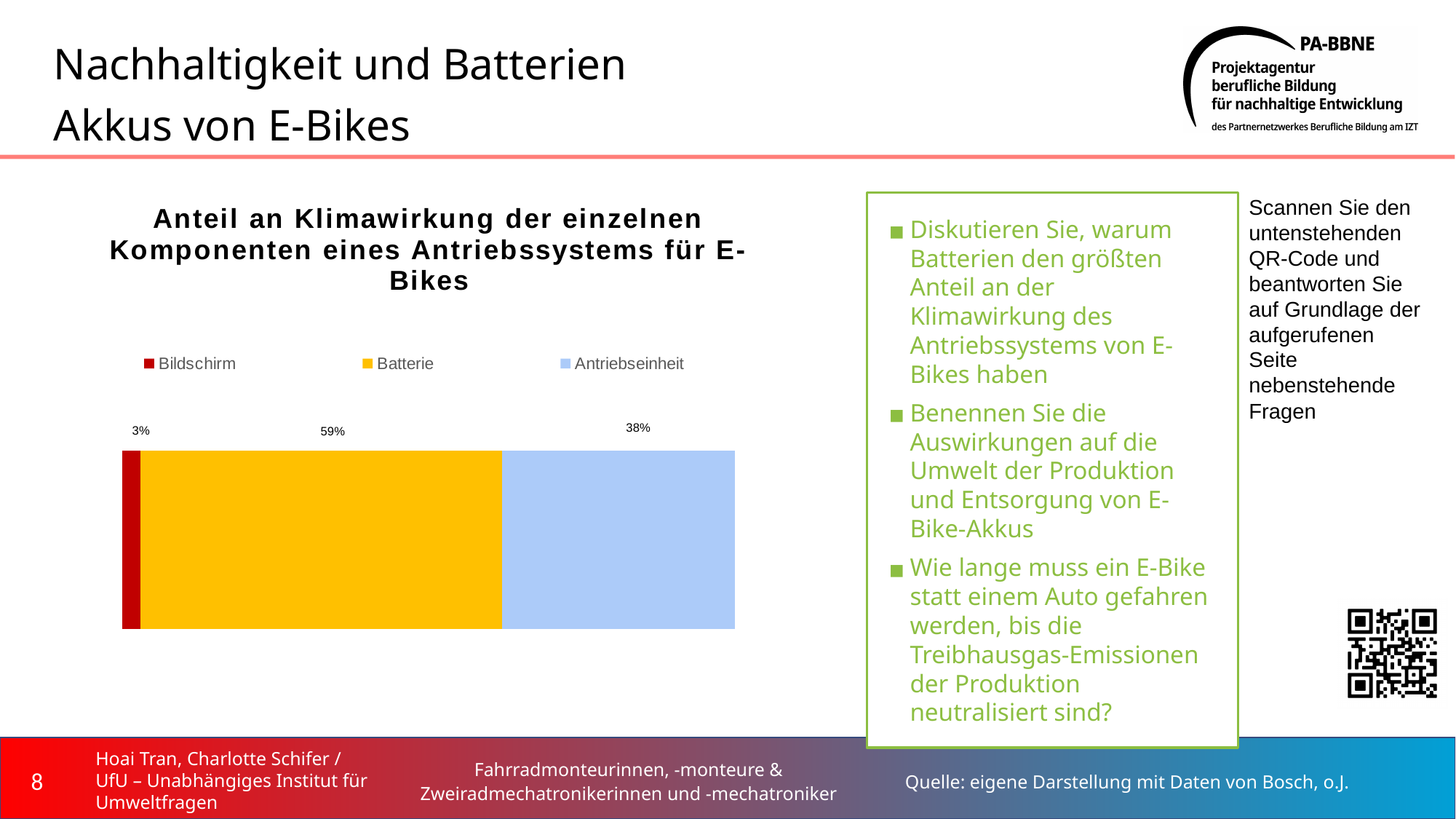
What is the title of the chart? Anteil an Klimawirkung der einzelnen Komponenten eines Antriebssystems für E-Bikes What type of chart is shown on the slide? Stacked bar chart Which component has the largest share of the climate impact in the chart? Batterie What value is shown for Antriebseinheit in the chart? 38% Which component has the smallest share of the climate impact in the chart? Bildschirm What value is shown for Bildschirm in the chart? 3% What share of the climate impact does the Batterie segment account for in the chart? 59% How many series does the chart legend list? 3 Which is larger, the share for Antriebseinheit or the share for Bildschirm? Antriebseinheit What is the total of the three segments in the stacked bar? 100% What is the difference in percentage points between the Batterie and Antriebseinheit shares? 21 Which colour represents Batterie in the chart? Yellow/orange